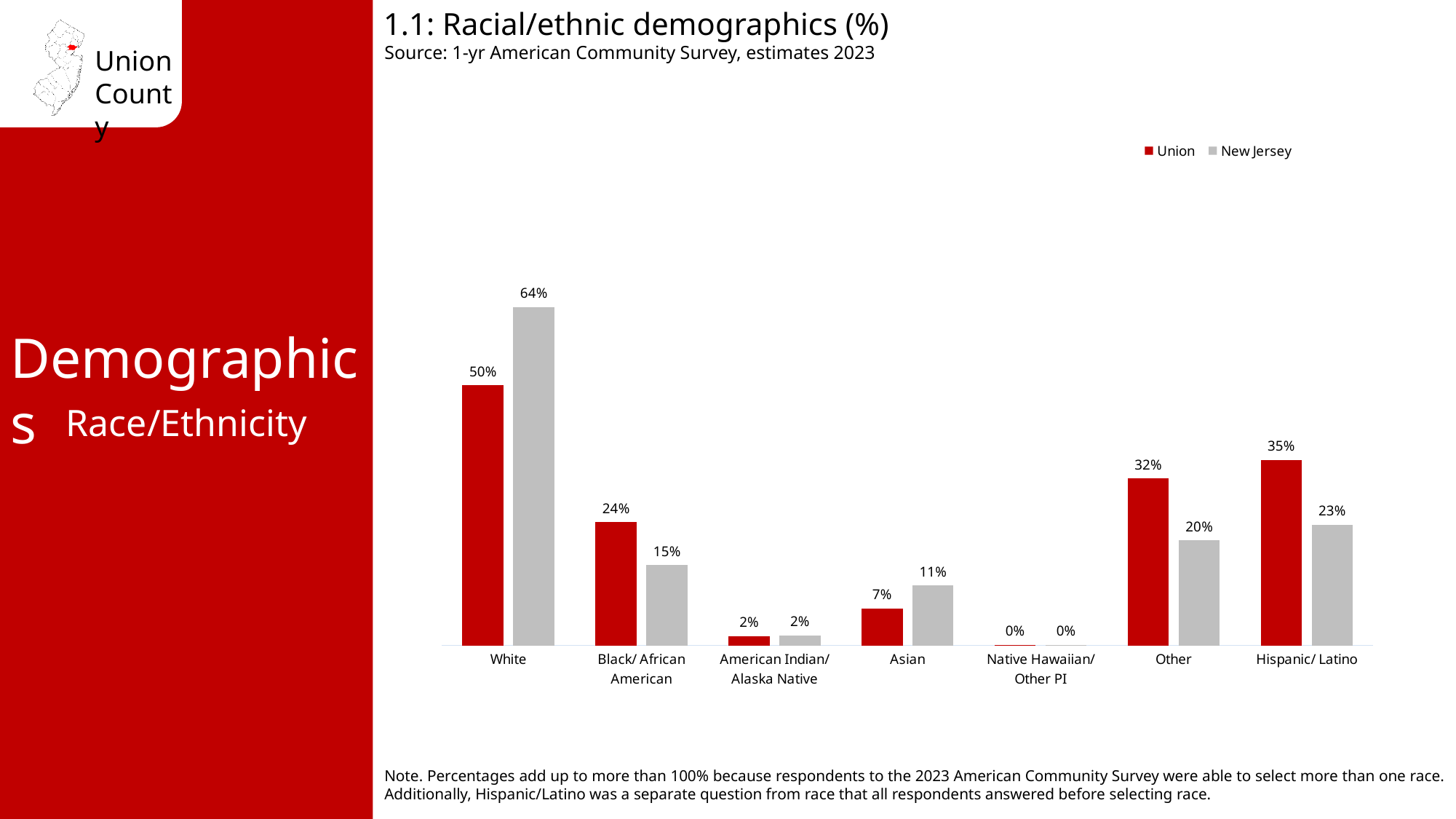
What is the difference between the New Jersey and Union values for White? 14% What is the New Jersey value for Hispanic/ Latino? 23% Which category has the lowest Union value? Native Hawaiian/ Other PI Which colour represents the Union series? Red What is the difference between the Union and New Jersey values for Other? 12% What is the Union value for Black/ African American? 24% How many categories are shown on the x axis? 7 Which is larger for Asian, the Union value or the New Jersey value? New Jersey Which category has the highest New Jersey value? White How many series does the legend list? 2 What is the Union value for White? 50% What kind of chart is shown? Bar chart